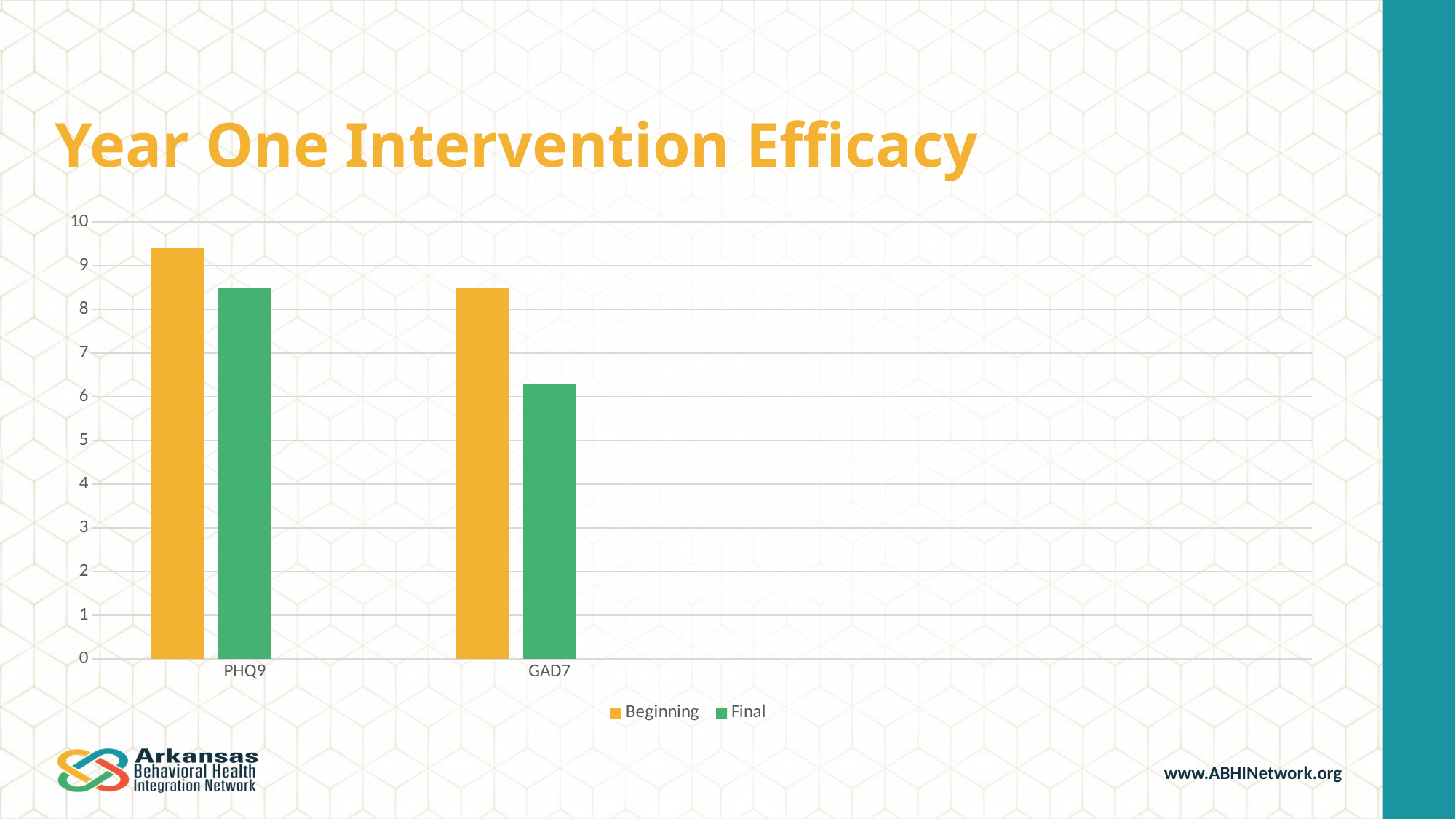
What are the two series named in the chart's legend? Beginning and Final What is the title of the slide containing the chart? Year One Intervention Efficacy For PHQ9, which is larger, the Beginning value or the Final value? Beginning Is the Beginning value for PHQ9 greater or less than 9? greater Is the Beginning value for GAD7 greater or less than 8? greater Which bar in the chart is the lowest? GAD7 Final Is the Final value for GAD7 greater or less than 6? greater How many categories are shown on the x axis of the chart? 2 How many series does the chart's legend list? 2 For GAD7, which is larger, the Beginning value or the Final value? Beginning What kind of chart is shown on the slide? bar chart